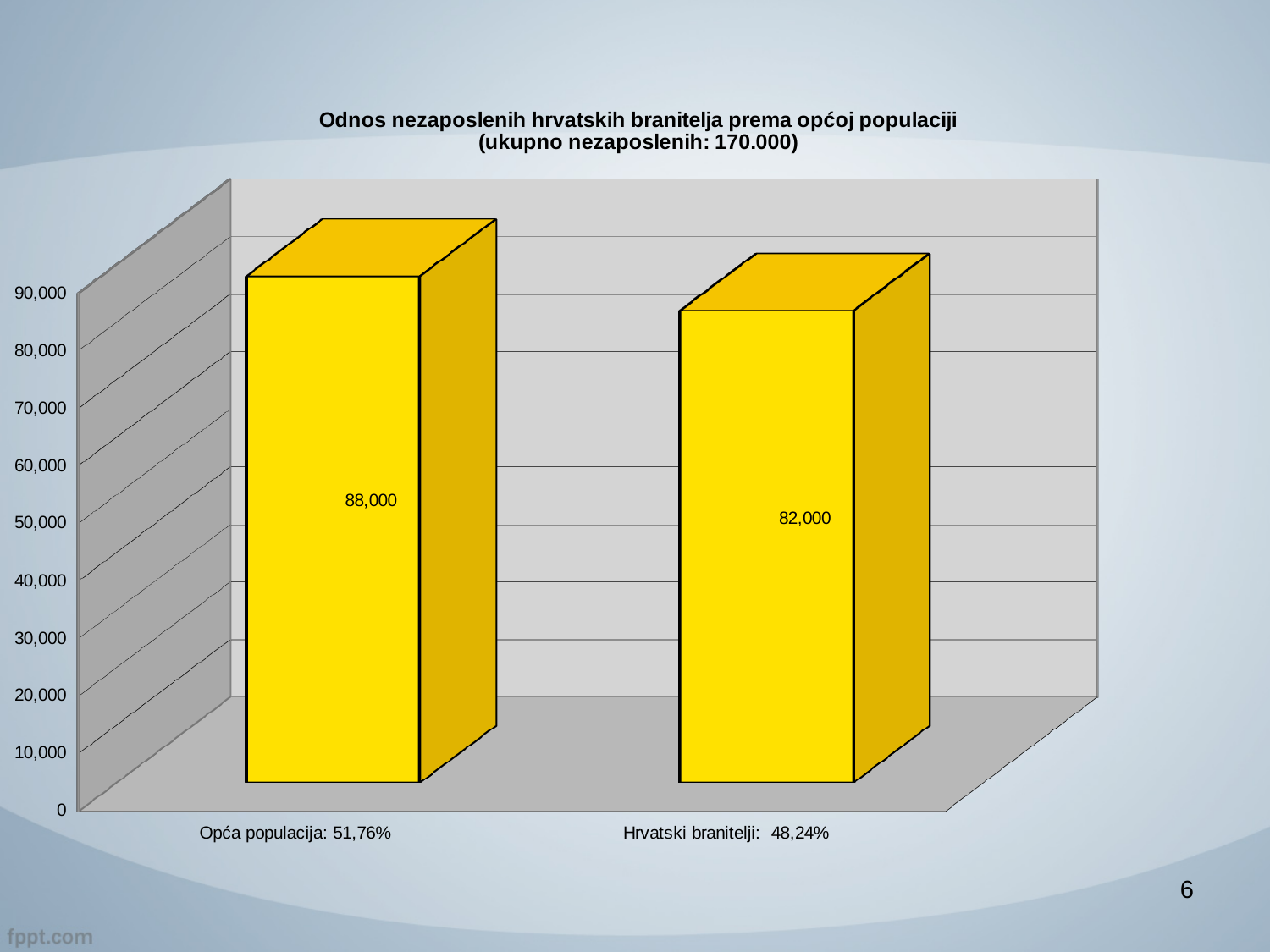
What is the value for Opća populacija: 51,76%? 88,000 Which category has the lowest value? Hrvatski branitelji: 48,24% What is the total of the two bars shown in the chart? 170,000 What is the title of the chart? Odnos nezaposlenih hrvatskih branitelja prema općoj populaciji (ukupno nezaposlenih: 170.000) How many categories are shown in the chart? 2 What colour are the bars in the chart? yellow Is the value for Hrvatski branitelji greater or less than 90,000? less What kind of chart is shown on the slide? bar chart Which is larger, the value for Opća populacija or the value for Hrvatski branitelji? Opća populacija Which category has the highest value? Opća populacija: 51,76% What is the difference between the values for Opća populacija and Hrvatski branitelji? 6,000 What is the value for Hrvatski branitelji: 48,24%? 82,000